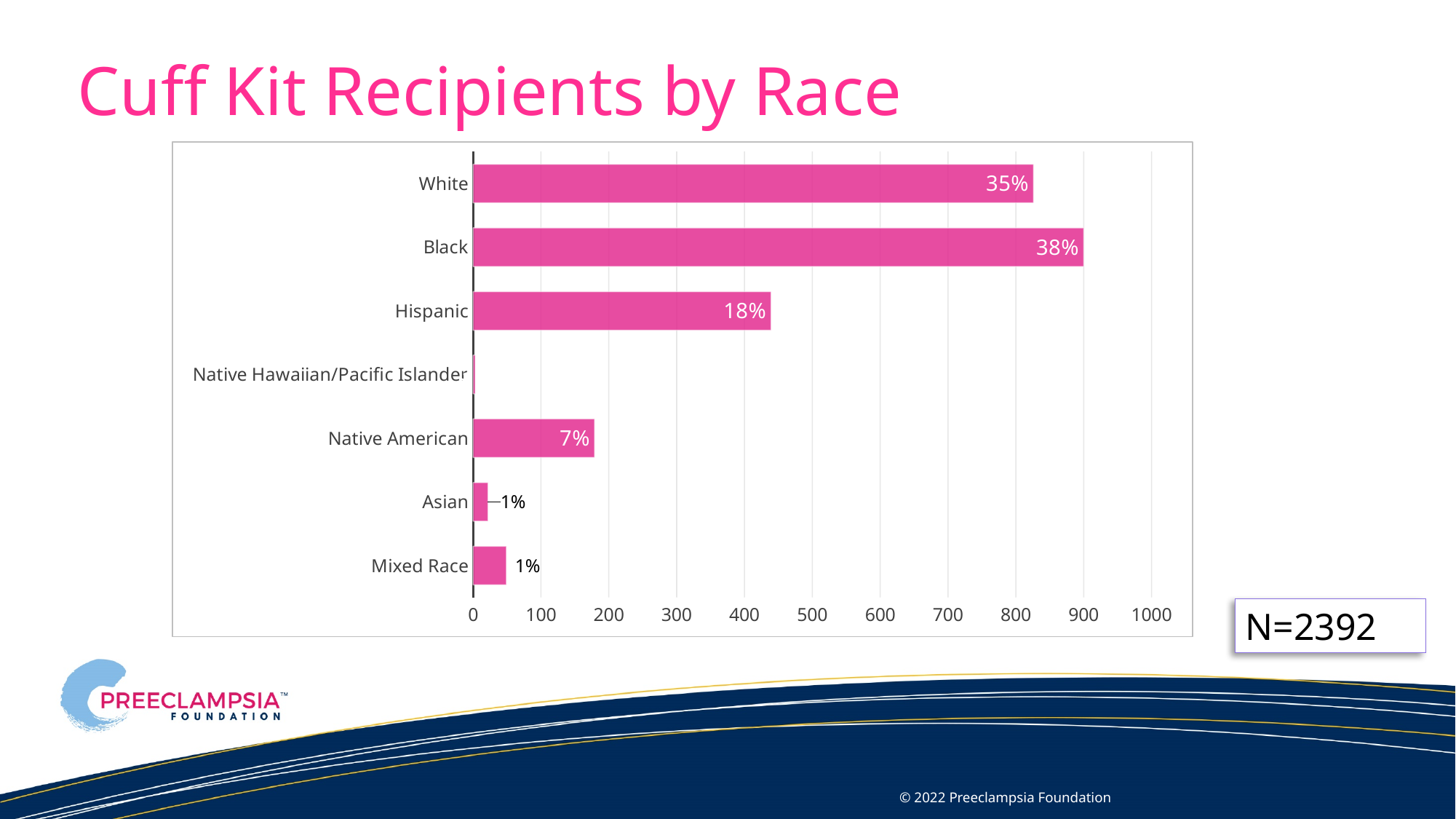
Is the value for White greater or less than 800? greater Which race category has the lowest value? Native Hawaiian/Pacific Islander What is the difference in percentage points between the Black and White labels? 3% What percentage label is shown for the White category? 35% How many race categories are shown in the chart? 7 What percentage label is shown for the Native American category? 7% What type of chart is shown on the slide? Bar chart What percentage label is shown for the Black category? 38% Which is larger, the value for Black or the value for White? Black Which race category has the highest value? Black What percentage label is shown for the Hispanic category? 18% Is the value for Native American greater or less than 200? less